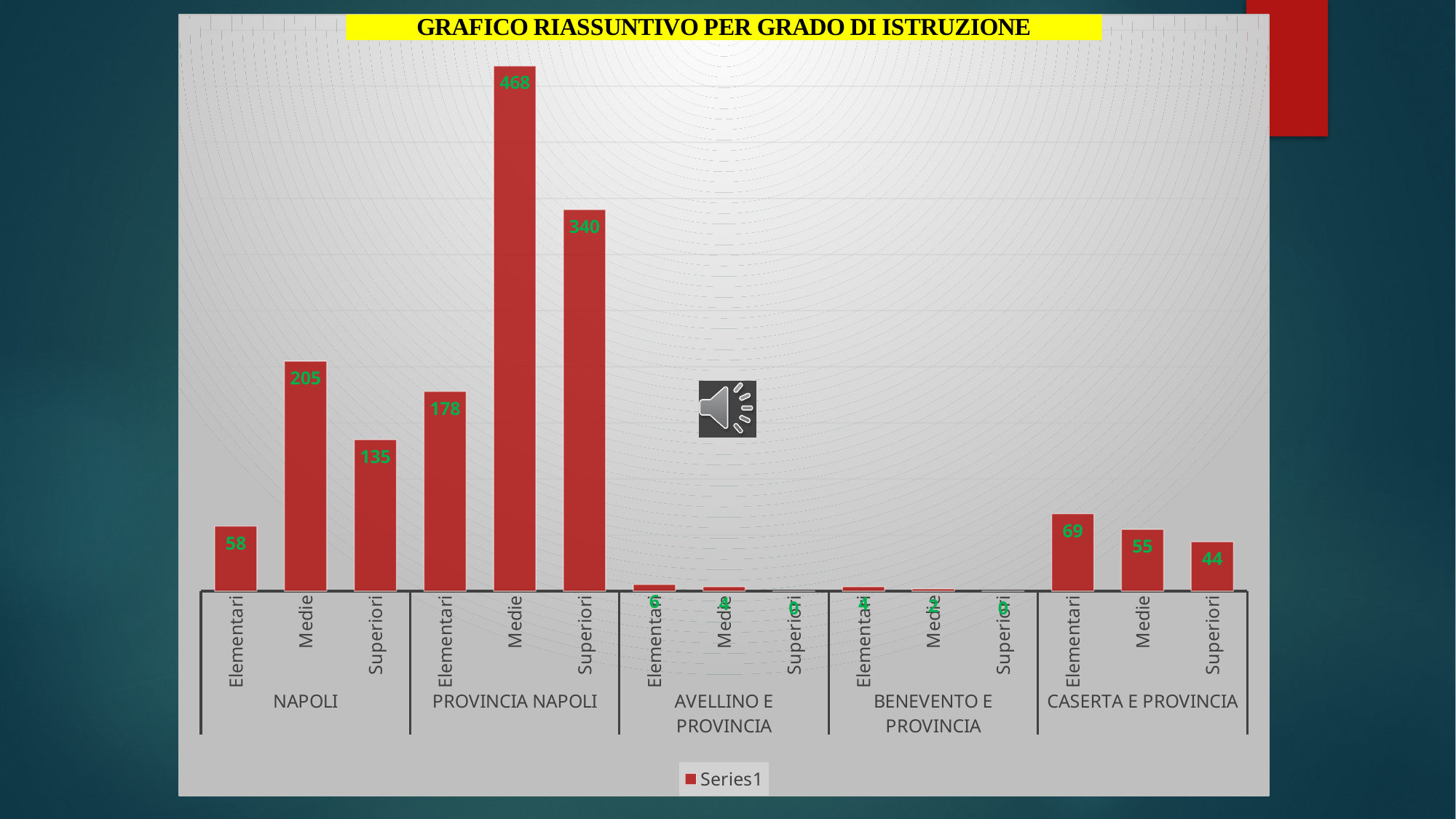
How many bars are plotted in the chart? 15 What is the difference between Medie in PROVINCIA NAPOLI and Medie in NAPOLI? 263 Which bar has the highest value in the chart? Medie in PROVINCIA NAPOLI What is the value for Medie in the PROVINCIA NAPOLI group? 468 What is the value for Elementari in the NAPOLI group? 58 How many province groups are shown on the x axis? 5 What is the value for Superiori in the CASERTA E PROVINCIA group? 44 What type of chart is shown on the slide? Bar chart Which is larger: Elementari in CASERTA E PROVINCIA or Elementari in NAPOLI? Elementari in CASERTA E PROVINCIA What is the difference between Medie and Superiori in the NAPOLI group? 70 What is the title of the chart? GRAFICO RIASSUNTIVO PER GRADO DI ISTRUZIONE What is the value for Superiori in the PROVINCIA NAPOLI group? 340